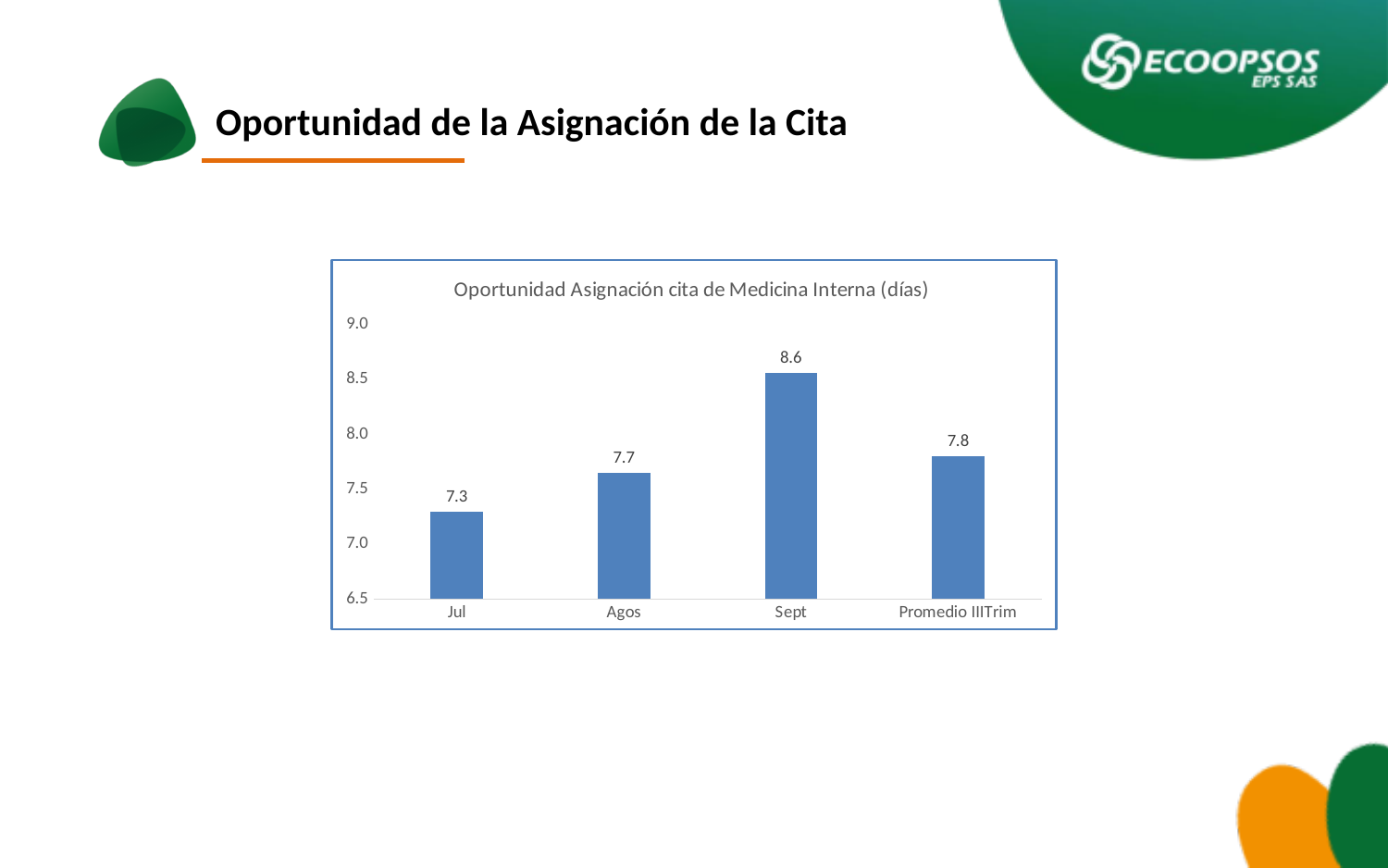
What is the value for Promedio IIITrim? 7.8 Is the value for Sept greater or less than 8.0? greater Which category has the lowest value? Jul Which is larger, the value for Agos or the value for Promedio IIITrim? Promedio IIITrim What is the value for Agos? 7.7 Which category has the highest value? Sept What is the value for Jul? 7.3 What is the title of the chart? Oportunidad Asignación cita de Medicina Interna (días) What is the difference between the values for Sept and Jul? 1.3 How many categories are shown on the x axis? 4 What is the value for Sept? 8.6 What kind of chart is shown on the slide? bar chart